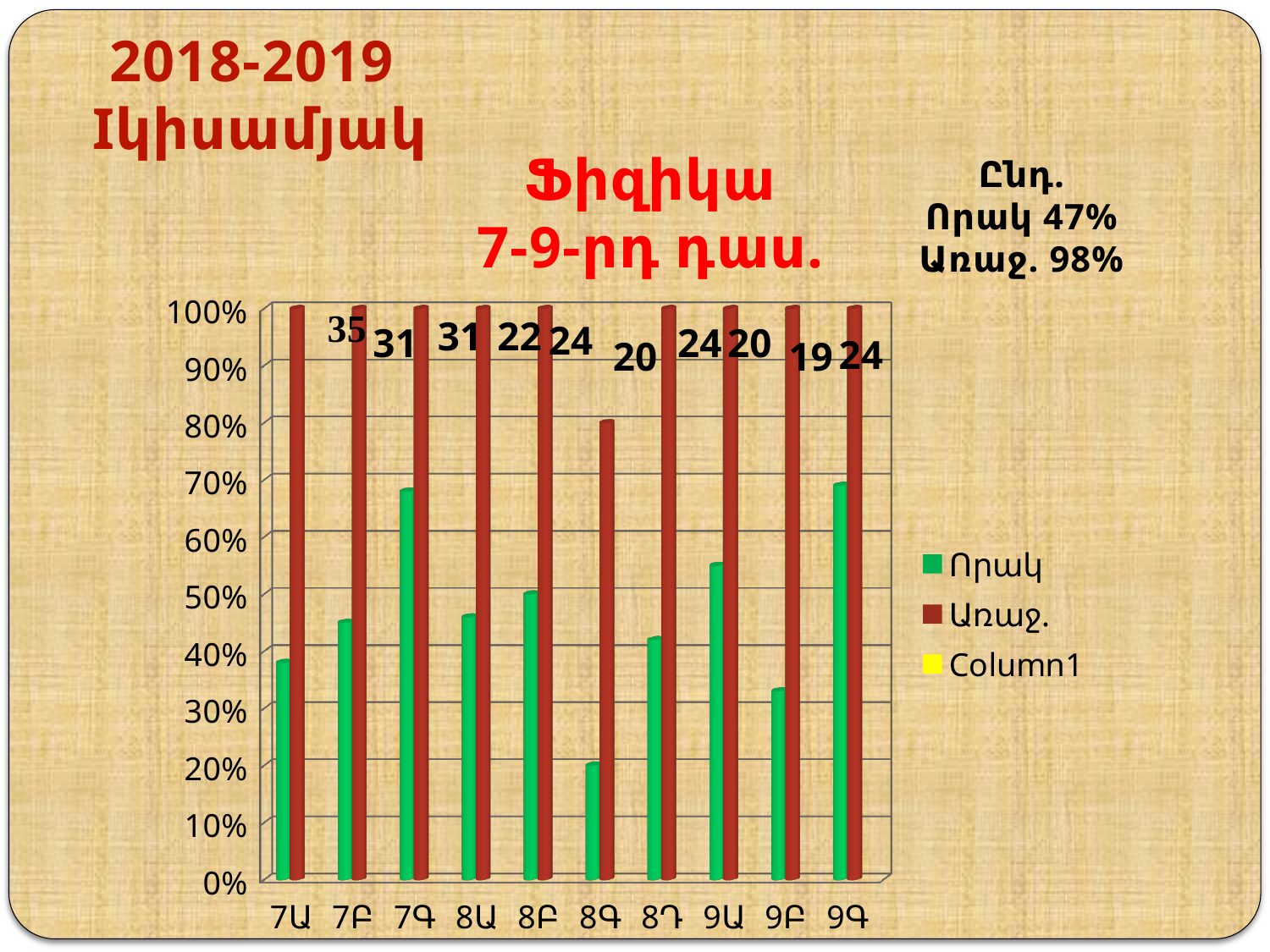
What is the Առաջ. value for class 7Ա? 100% Which class has the lowest Առաջ. value? 8Գ Is the Որակ value for class 7Գ greater or less than 60%? greater Which class has the lowest Որակ value? 8Գ What is the Որակ value for class 8Գ? 20% What is the Առաջ. value for class 8Գ? 80% Is the Որակ value for class 9Բ greater or less than 40%? less Which class has the larger Որակ value, 7Գ or 8Գ? 7Գ Which series is shown in green in the chart legend? Որակ How many classes (categories) are shown on the x axis of the chart? 10 How many series does the chart legend list? 3 What kind of chart is shown on the slide? bar chart